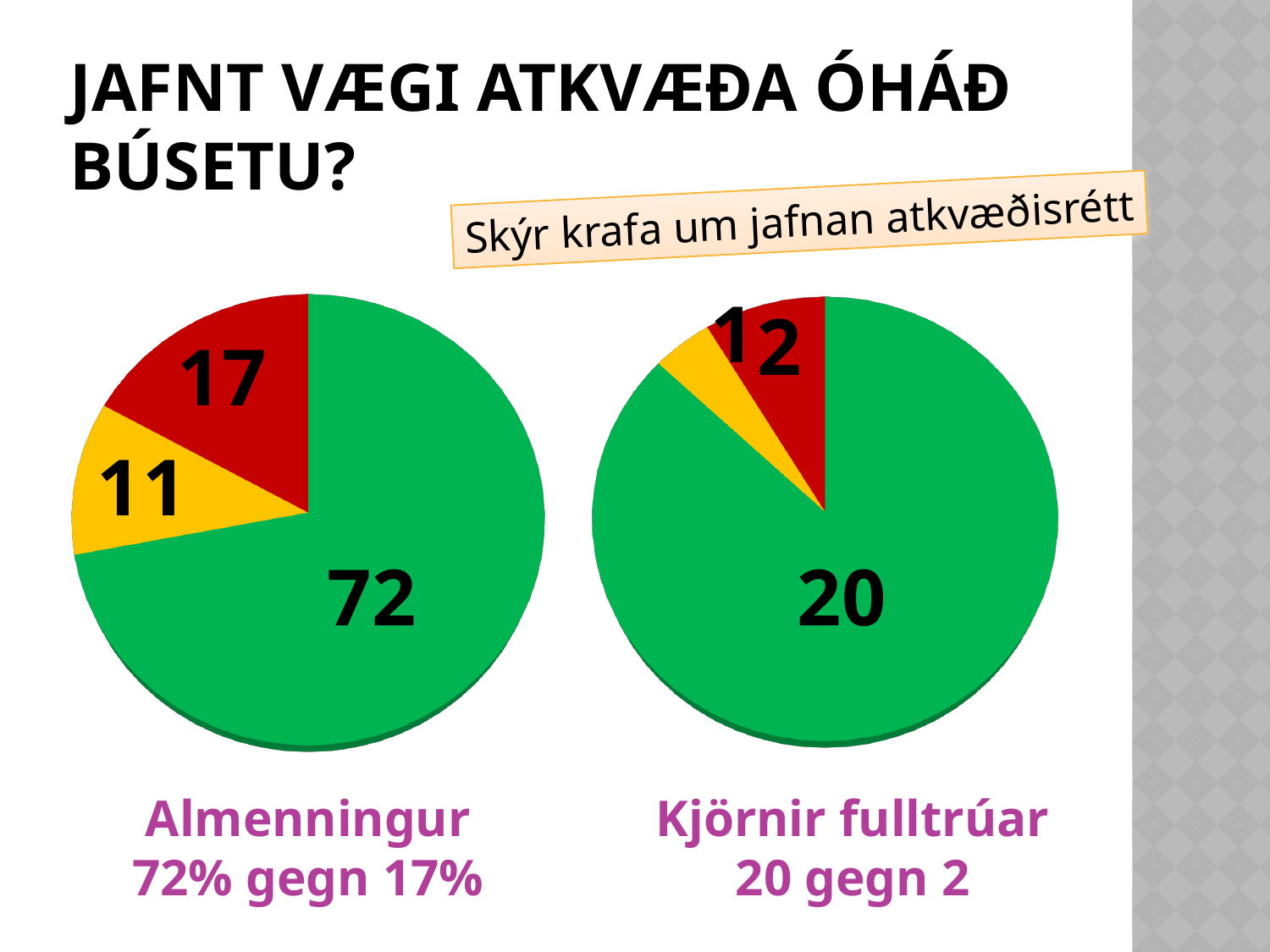
In the Almenningur pie chart, what value is shown for the red slice? 17 How many slices does the Almenningur pie chart have? 3 In the Almenningur pie chart, what value is shown for the yellow slice? 11 In the Almenningur pie chart, which slice is the largest? The green slice (72) How many pie charts are on the slide? 2 In the Kjörnir fulltrúar pie chart, what value is shown for the green slice? 20 In the Almenningur pie chart, what is the difference between the red slice and the yellow slice? 6 In the Almenningur pie chart, what value is shown for the green slice? 72 In the Almenningur pie chart, which is larger, the red slice or the yellow slice? The red slice What is the title of the slide? JAFNT VÆGI ATKVÆÐA ÓHÁÐ BÚSETU? In the Almenningur pie chart, which slice is the smallest? The yellow slice (11) What kind of charts are shown on the slide? Pie charts